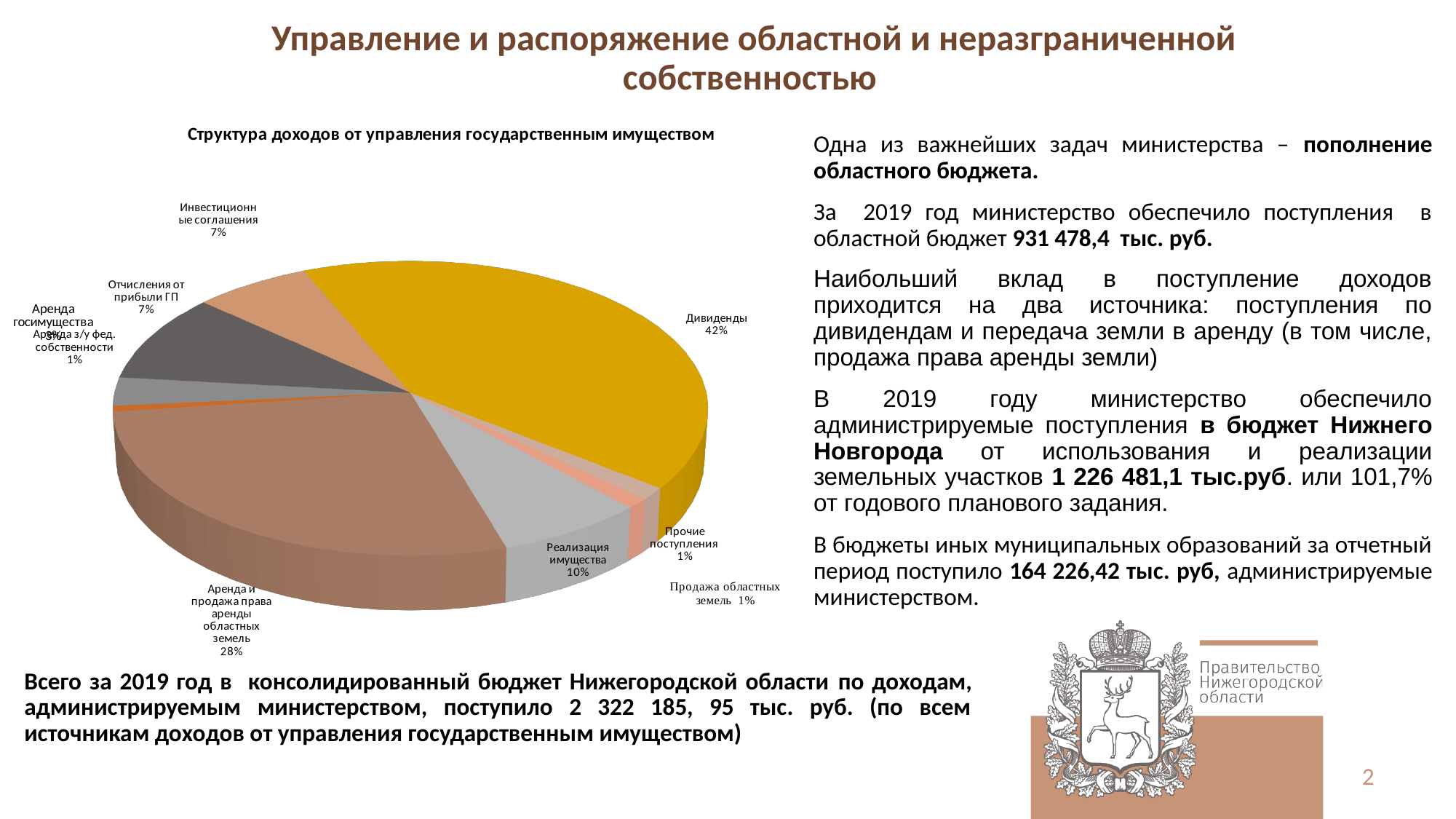
What type of chart is shown on the slide? Pie chart Which category has the largest share of the pie? Дивиденды What percentage is shown for Прочие поступления? 1% What percentage is shown for Инвестиционные соглашения? 7% What share of the pie does Дивиденды represent? 42% What is the difference in percentage points between Реализация имущества and Отчисления от прибыли ГП? 3 percentage points What percentage is shown for Реализация имущества? 10% Which is larger: the share for Дивиденды or the share for Аренда и продажа права аренды областных земель? Дивиденды What is the title of the chart? Структура доходов от управления государственным имуществом What is the difference in percentage points between Дивиденды and Аренда и продажа права аренды областных земель? 14 percentage points How many categories (slices) are labelled in the pie chart? 9 What percentage is shown for Аренда и продажа права аренды областных земель? 28%